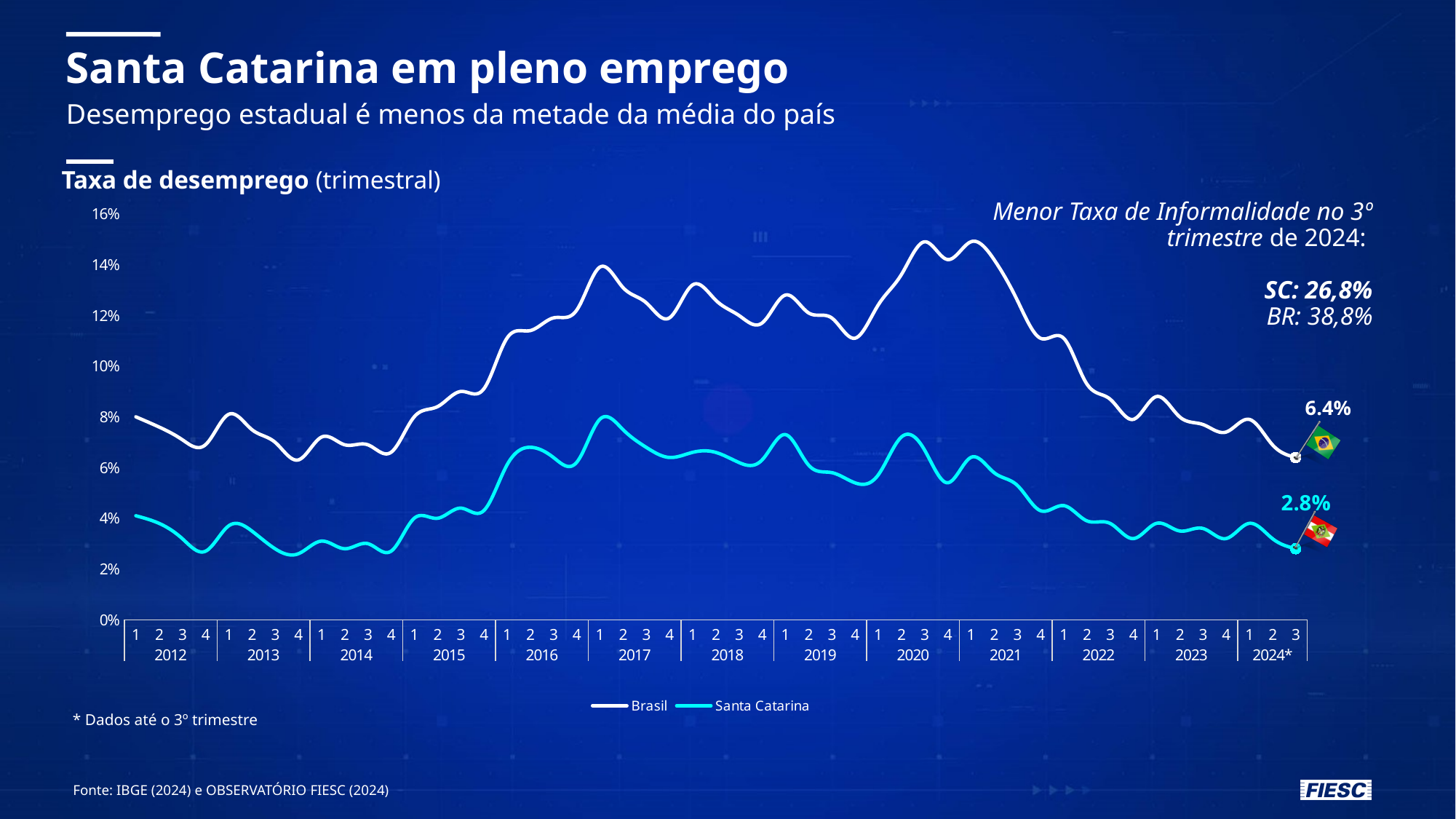
What is the difference between the Brasil and Santa Catarina unemployment rates in the 3rd quarter of 2024? 3.6% Is the Santa Catarina unemployment rate in the 3rd quarter of 2020 greater or less than 6%? greater What is the unemployment rate for Santa Catarina in the 3rd quarter of 2024 according to the chart? 2.8% How many years are shown on the x axis of the chart? 13 Is the Brasil unemployment rate at its 2020 peak greater or less than 14%? greater Which series has the higher value in the 3rd quarter of 2024, Brasil or Santa Catarina? Brasil How many series does the legend of the chart list? 2 What is the title of the chart? Taxa de desemprego (trimestral) What is the unemployment rate for Brasil in the 3rd quarter of 2024 according to the chart? 6.4% Is the Brasil unemployment rate in the 2nd quarter of 2014 greater or less than 8%? less What kind of chart is shown on the slide? Line chart Does the Brasil unemployment rate rise or fall from 2021 to 2024? Fall